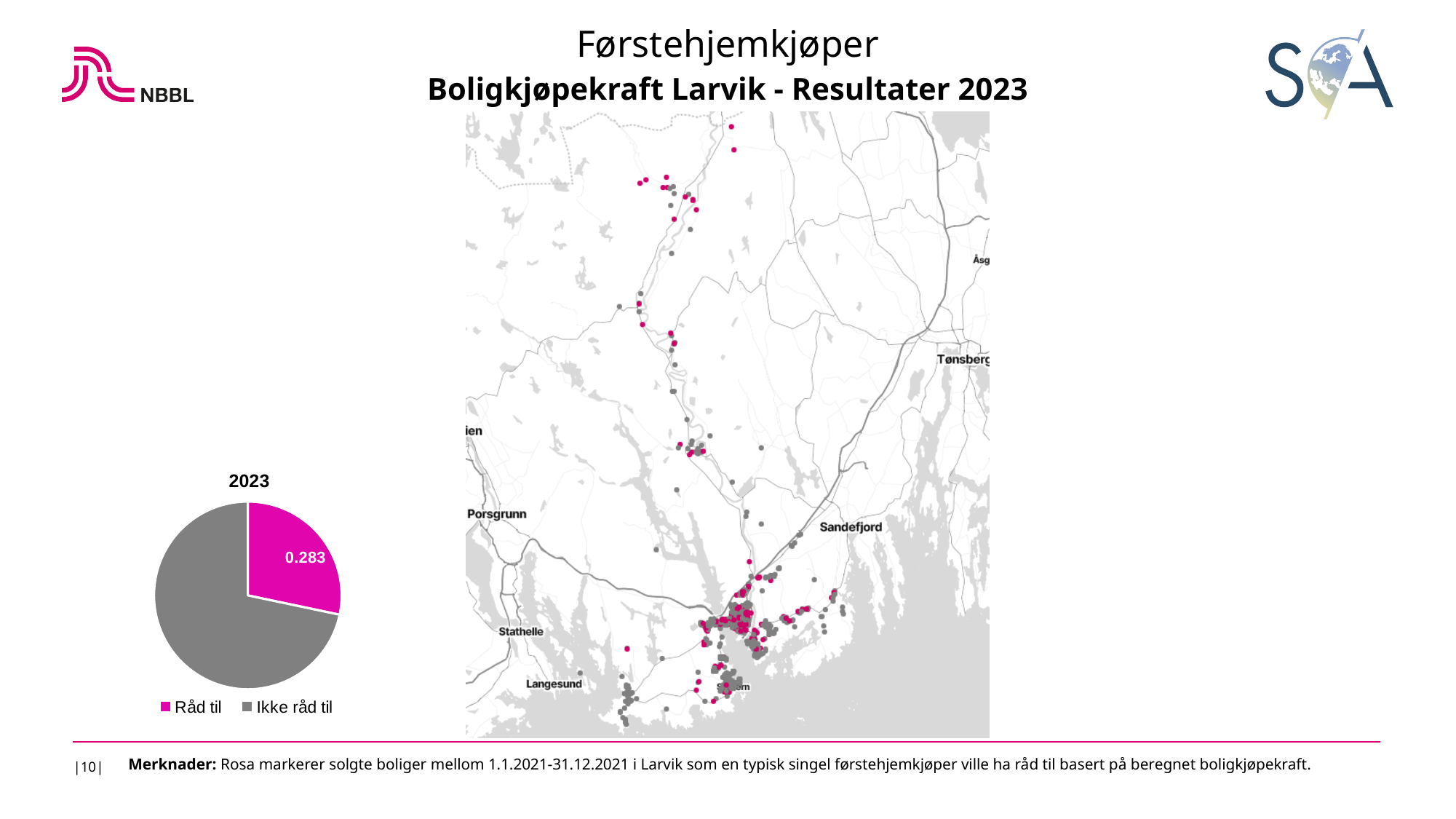
How many slices does the pie chart have? 2 Which slice of the pie chart is the largest? Ikke råd til In the pie chart, which is larger: Råd til or Ikke råd til? Ikke råd til What colour is the Råd til slice in the pie chart? pink What is the title shown above the pie chart? 2023 How many entries does the pie chart's legend list? 2 In the pie chart, what value is shown for Råd til? 0.283 Which slice of the pie chart is the smallest? Råd til What kind of chart is shown on the left of the slide? pie chart